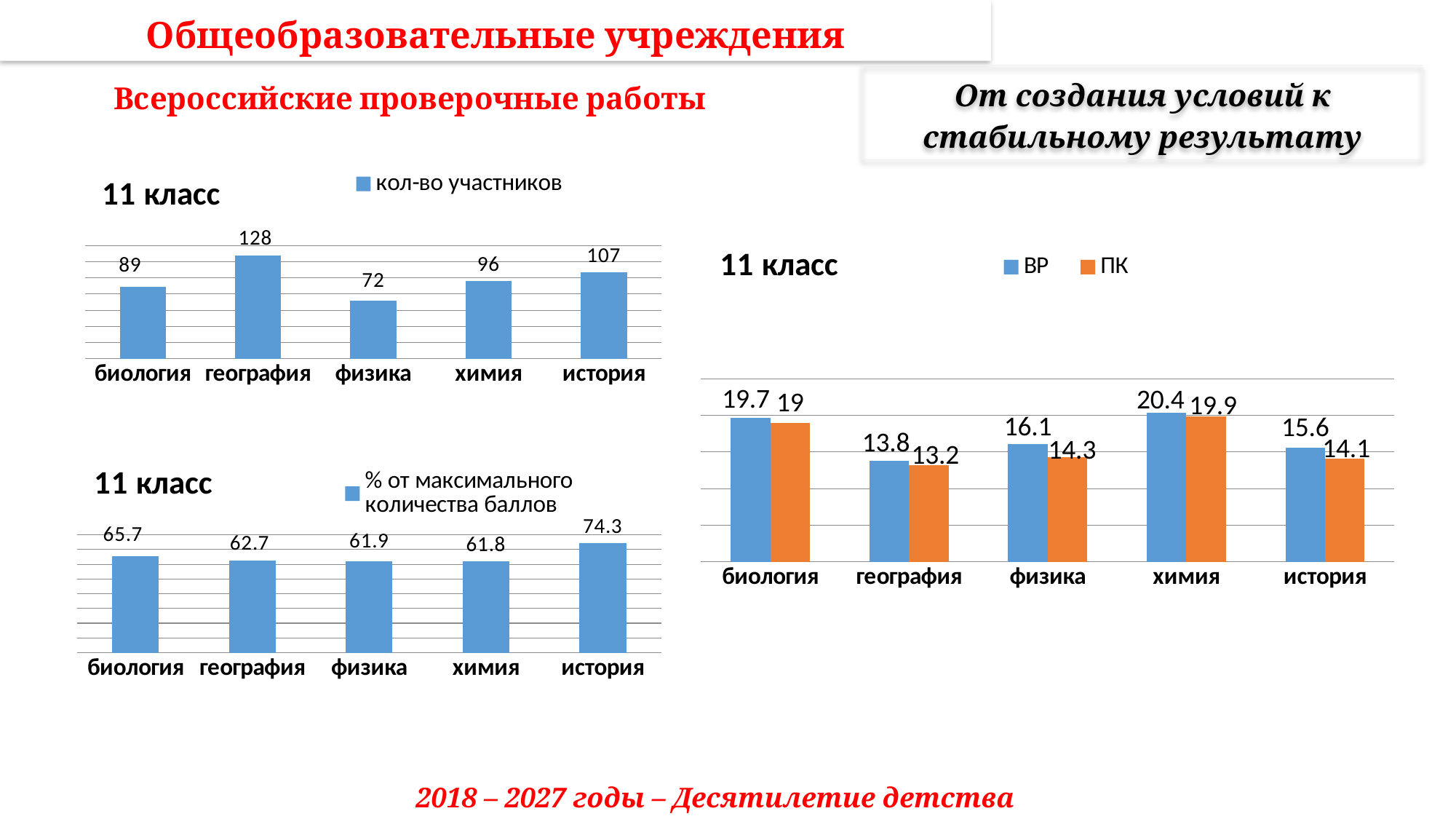
In the top-left chart (кол-во участников), what is the value for география? 128 In the top-left chart (кол-во участников), which category has the lowest value? физика In the bottom-left chart (% от максимального количества баллов), what is the value for история? 74.3 In the bottom-left chart (% от максимального количества баллов), which category has the highest value? история In the right-hand chart (ВР / ПК), how many series does the legend list? 2 In the top-left chart (кол-во участников), what is the difference between история and биология? 18 In the right-hand chart (ВР / ПК), what is the ВР value for химия? 20.4 In the right-hand chart (ВР / ПК), what is the ПК value for физика? 14.3 In the right-hand chart (ВР / ПК), what is the difference between the ВР and ПК values for физика? 1.8 In the bottom-left chart (% от максимального количества баллов), which is larger: биология or география? биология In the top-left chart (кол-во участников), how many categories are shown? 5 What type of chart is the right-hand chart (ВР / ПК)? bar chart